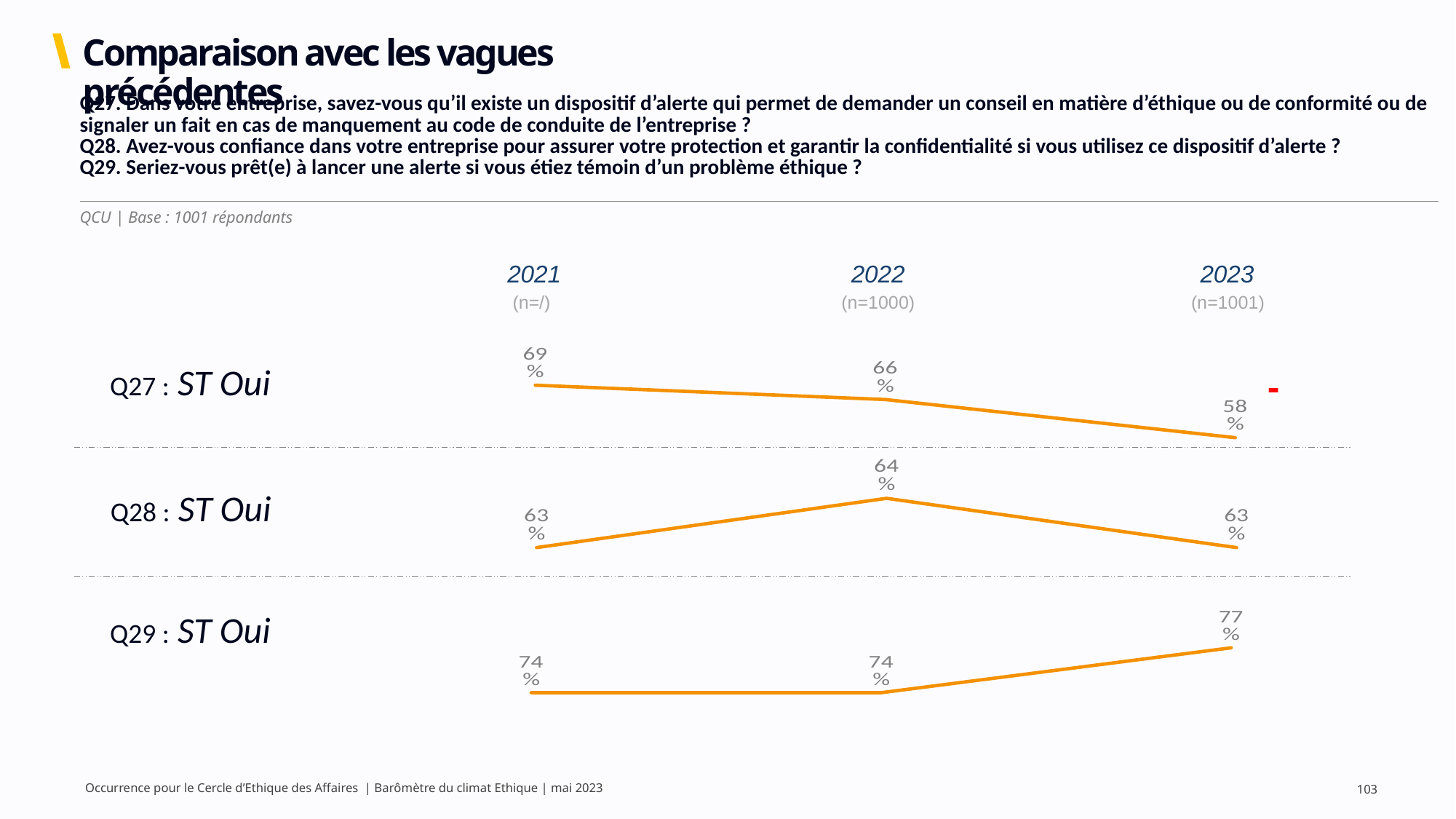
How many years (data points) are plotted in the Q28 : ST Oui chart? 3 In the Q27 : ST Oui chart, what is the value for 2023? 58% What kind of chart is used for Q29 : ST Oui? line chart In the Q27 : ST Oui chart, what is the value for 2021? 69% In the Q27 : ST Oui chart, do the values rise or fall from 2021 to 2023? fall In the Q28 : ST Oui chart, what is the value for 2022? 64% In the Q29 : ST Oui chart, what is the difference between the 2023 and 2022 values? 3 percentage points In the Q29 : ST Oui chart, what is the value for 2023? 77% In the Q27 : ST Oui chart, what is the difference between the 2021 and 2023 values? 11 percentage points In the Q29 : ST Oui chart, is the value for 2023 larger or smaller than the value for 2021? larger In the Q27 : ST Oui chart, which year has the lowest value? 2023 In the Q28 : ST Oui chart, which year has the highest value? 2022